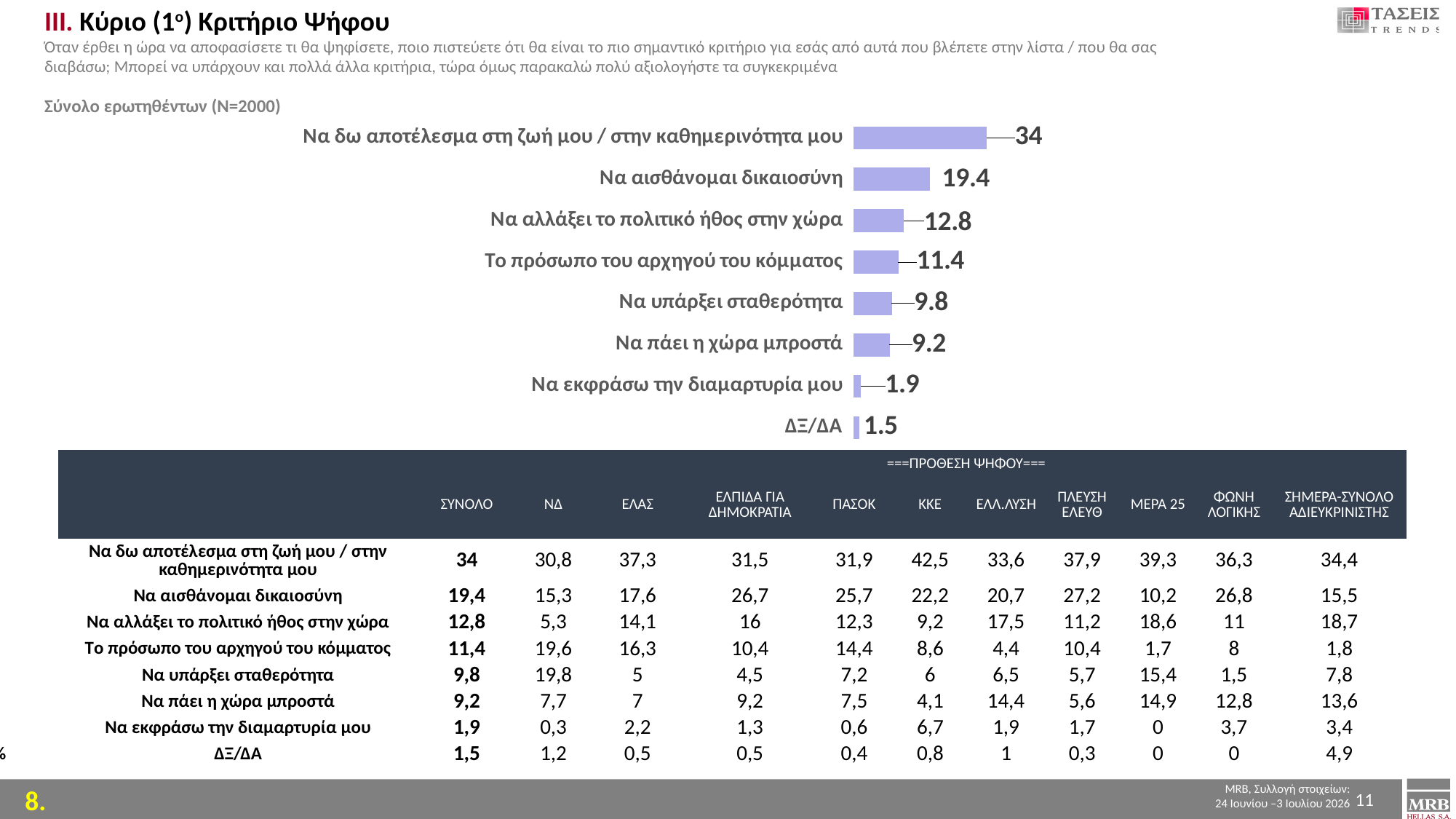
Which is larger in the bar chart: "Να υπάρξει σταθερότητα" or "Να πάει η χώρα μπροστά"? Να υπάρξει σταθερότητα What value is shown for "Να αισθάνομαι δικαιοσύνη" in the bar chart? 19.4 Which category has the lowest value in the bar chart? ΔΞ/ΔΑ How many categories are shown in the bar chart? 8 What value is shown for "Να δω αποτέλεσμα στη ζωή μου / στην καθημερινότητα μου" in the bar chart? 34 What value is shown for "Να υπάρξει σταθερότητα" in the bar chart? 9.8 What value is shown for "ΔΞ/ΔΑ" in the bar chart? 1.5 What is the difference between the values for "Να αλλάξει το πολιτικό ήθος στην χώρα" and "Το πρόσωπο του αρχηγού του κόμματος"? 1.4 What kind of chart is shown on the slide? Bar chart Which category has the highest value in the bar chart? Να δω αποτέλεσμα στη ζωή μου / στην καθημερινότητα μου What is the difference between the values for "Να δω αποτέλεσμα στη ζωή μου / στην καθημερινότητα μου" and "Να αισθάνομαι δικαιοσύνη"? 14.6 Do the values in the bar chart increase or decrease from the top category to the bottom category? Decrease